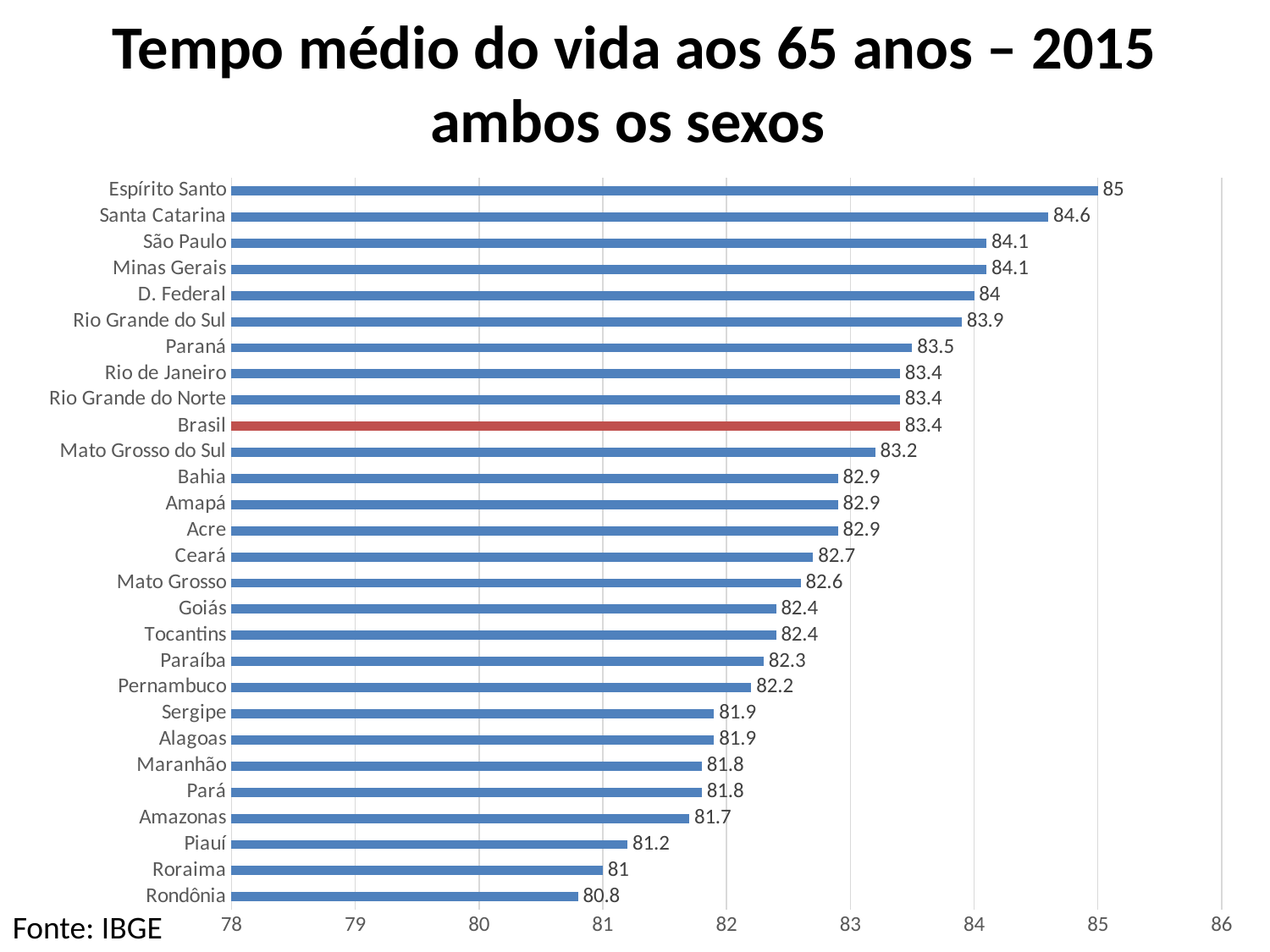
Which has a larger value, Paraná or Piauí? Paraná Is the value for D. Federal greater or less than 83? greater What kind of chart is this? Bar chart What is the value for Rondônia? 80.8 Which category has the lowest value? Rondônia What is the value for Santa Catarina? 84.6 What is the value for Brasil? 83.4 What is the difference between the values for Santa Catarina and Brasil? 1.2 How many categories are shown in the chart? 28 Which category has the highest value? Espírito Santo What is the difference between the values for Espírito Santo and Rondônia? 4.2 Which bar is shown in a different colour (red) from the others? Brasil